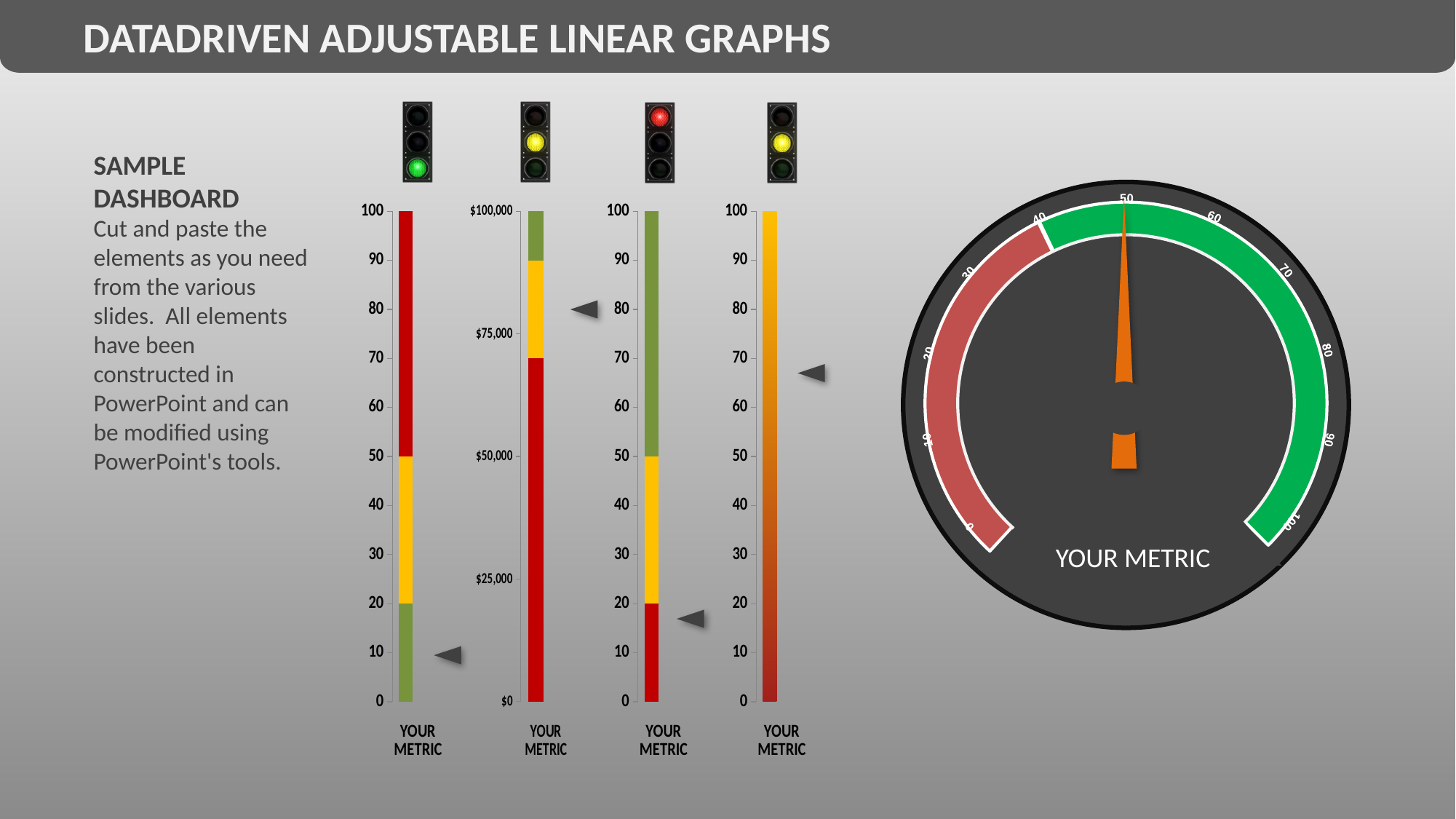
On the second bar chart from the left, what is the top axis label? $100,000 On the leftmost bar chart, at what axis value does the green segment end and the yellow segment begin? 20 On the leftmost bar chart, at what axis value does the yellow segment end and the red segment begin? 50 On the rightmost bar chart, is the value marked by the arrow greater or less than 60? greater What kind of chart is the leftmost 'YOUR METRIC' chart? bar chart On the gauge chart, what value does the needle point to? 50 On the third bar chart from the left, at what axis value does the red segment end? 20 On the leftmost bar chart, what is the maximum value shown on the axis? 100 How many vertical bar charts labelled 'YOUR METRIC' are on the slide? 4 On the third bar chart from the left, at what axis value does the green segment begin? 50 What is the title shown inside the gauge chart? YOUR METRIC On the gauge chart, at what value does the red band end and the green band begin? 40